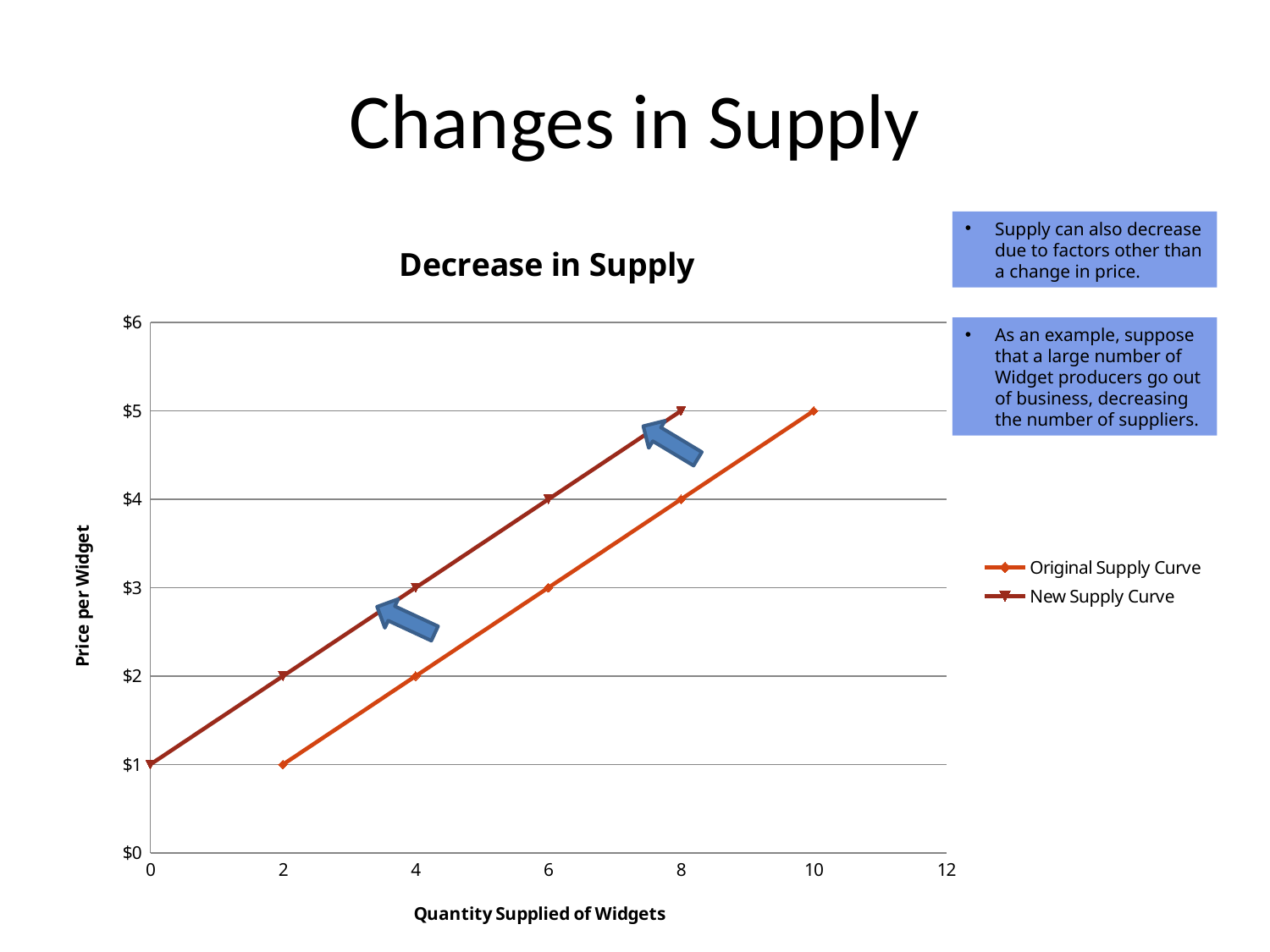
Does the price per widget rise or fall as quantity supplied increases along the Original Supply Curve? rise At a price of $4, what is the difference in quantity supplied between the Original Supply Curve and the New Supply Curve? 2 What are the two series named in the legend? Original Supply Curve and New Supply Curve How many data points are plotted on the Original Supply Curve? 5 On the New Supply Curve, what is the price per widget when the quantity supplied is 0? $1 At a price of $3, what quantity is supplied on the Original Supply Curve? 6 What kind of chart is shown on the slide? line chart What is the title of the chart? Decrease in Supply On the Original Supply Curve, what is the price per widget when the quantity supplied is 10? $5 How many series does the chart legend list? 2 On the New Supply Curve, what is the price per widget when the quantity supplied is 8? $5 At a quantity supplied of 4, which series shows the higher price per widget? New Supply Curve